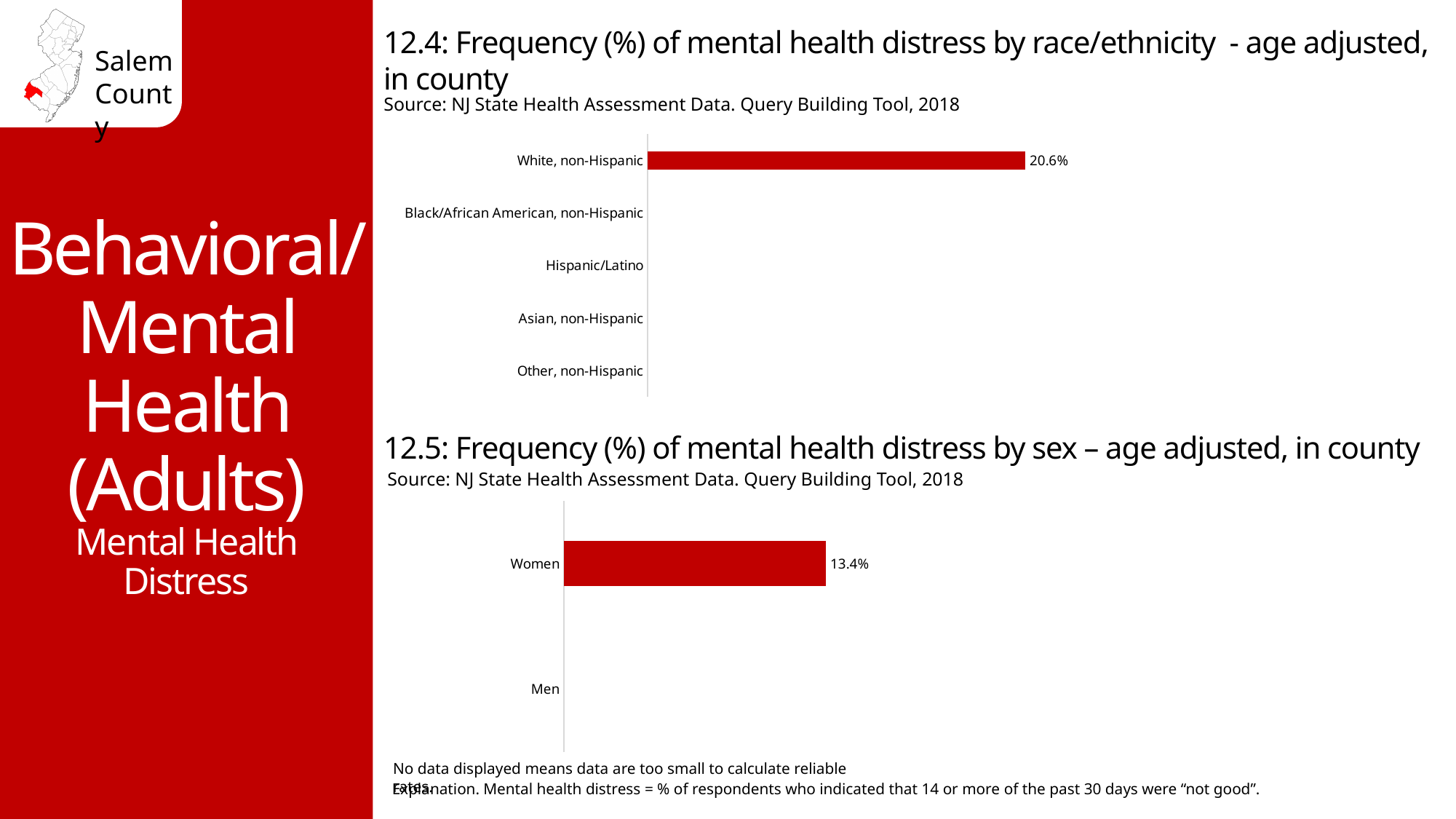
Which is larger: the value for White, non-Hispanic in chart 12.4 or the value for Women in chart 12.5? White, non-Hispanic In the chart '12.5: Frequency (%) of mental health distress by sex', what colour is the bar for Women? Red How many categories are listed on the axis of the chart '12.5: Frequency (%) of mental health distress by sex'? 2 What kind of chart is '12.5: Frequency (%) of mental health distress by sex'? Bar chart What is the difference between the value for White, non-Hispanic in chart 12.4 and the value for Women in chart 12.5? 7.2 percentage points In the chart '12.5: Frequency (%) of mental health distress by sex', which category has a bar displayed? Women In the chart '12.5: Frequency (%) of mental health distress by sex – age adjusted, in county', what is the value for Women? 13.4% In the chart '12.4: Frequency (%) of mental health distress by race/ethnicity - age adjusted, in county', what is the value for White, non-Hispanic? 20.6% In the chart '12.4: Frequency (%) of mental health distress by race/ethnicity', which category is the only one with a bar displayed? White, non-Hispanic What is the data source cited for the chart '12.4: Frequency (%) of mental health distress by race/ethnicity'? NJ State Health Assessment Data. Query Building Tool, 2018 How many race/ethnicity categories are listed on the axis of the chart '12.4: Frequency (%) of mental health distress by race/ethnicity'? 5 What kind of chart is '12.4: Frequency (%) of mental health distress by race/ethnicity'? Bar chart